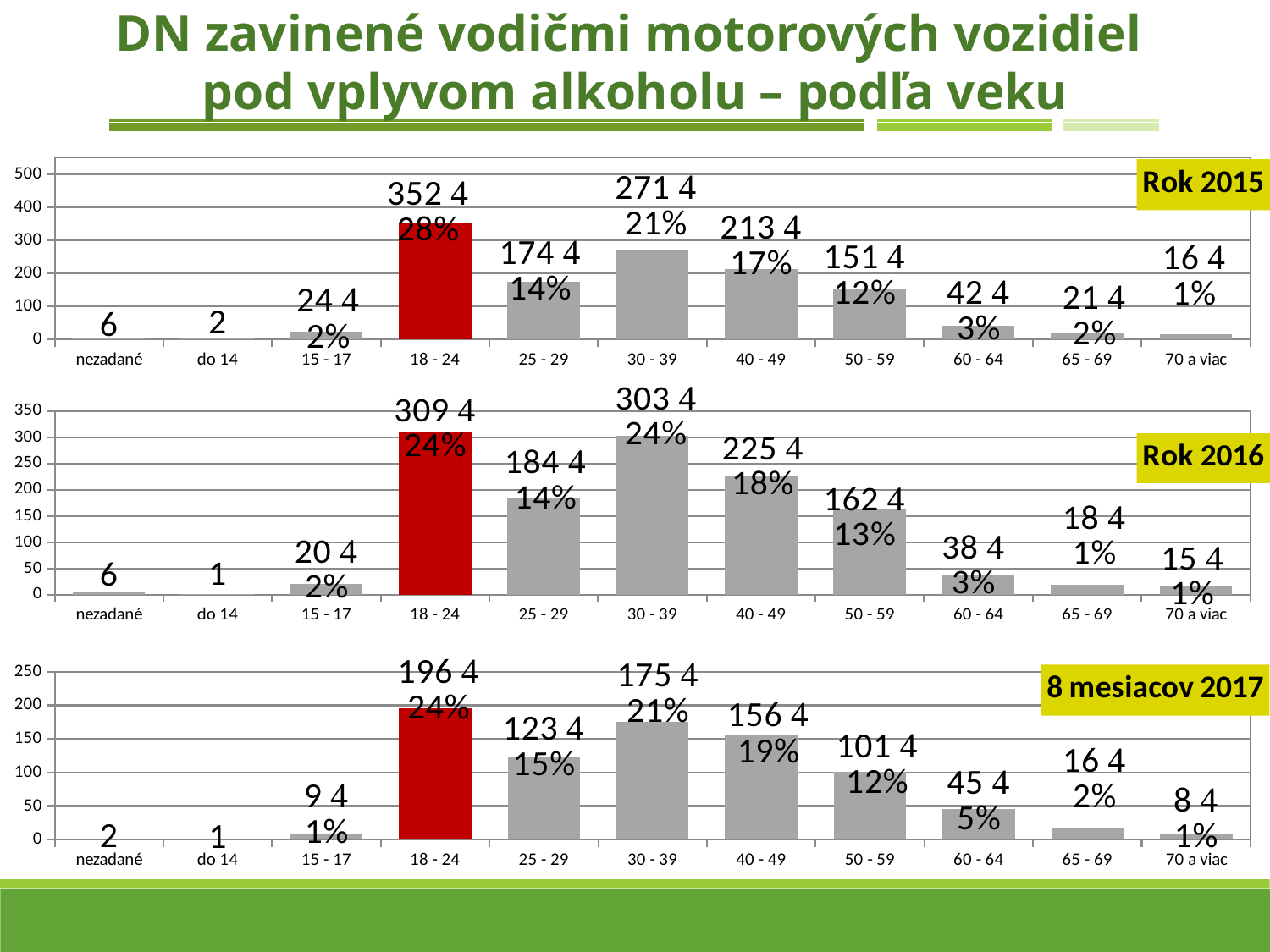
In the Rok 2015 chart, what percentage is shown for the 18 - 24 age group? 28% In the 8 mesiacov 2017 chart, what is the value for the nezadané category? 2 How many age categories are shown on the x axis of the Rok 2015 chart? 11 In the Rok 2016 chart, is the value for 40 - 49 greater or less than 200? greater In the 8 mesiacov 2017 chart, which age group's bar is coloured red? 18 - 24 In the Rok 2015 chart, which age group has the highest bar? 18 - 24 In the 8 mesiacov 2017 chart, what percentage is shown for the 40 - 49 age group? 19% In the Rok 2015 chart, which is larger: the value for 25 - 29 or for 30 - 39? 30 - 39 In the Rok 2015 chart, which age group has the lowest value? do 14 What type of chart is used for the Rok 2016 data? bar chart In the Rok 2016 chart, what percentage is shown for the 30 - 39 age group? 24% In the Rok 2016 chart, what is the value for the do 14 category? 1